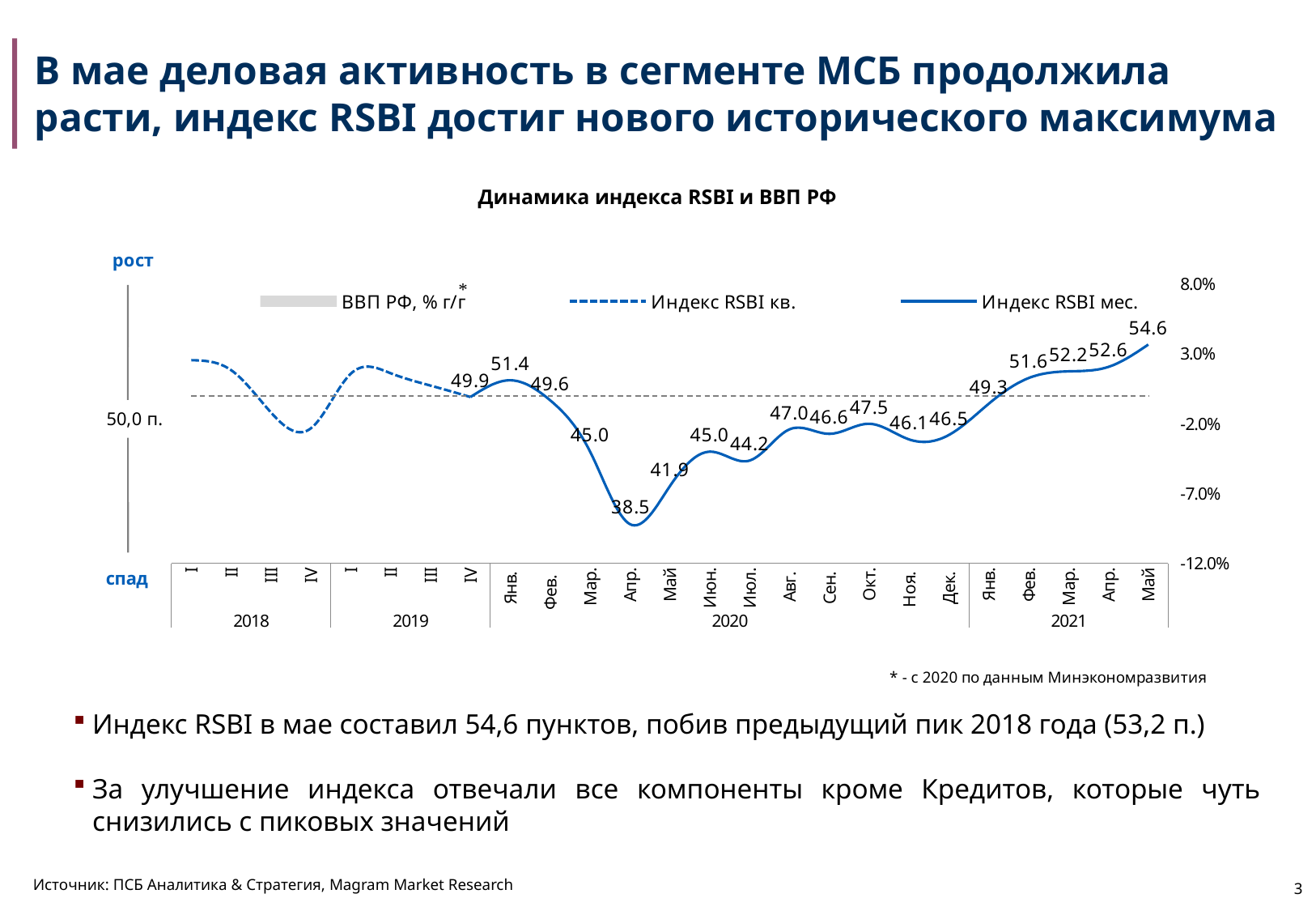
How many series does the chart legend list? 3 What kind of chart is used to show the RSBI index? line chart Is the monthly RSBI index for March 2020 greater or less than 50? less What is the value of the monthly RSBI index (Индекс RSBI мес.) for May 2021? 54.6 Does the monthly RSBI index rise or fall from April 2020 to May 2021? rise In which month does the monthly RSBI index reach its highest labelled value? Май 2021 What is the value of the monthly RSBI index for April 2020? 38.5 What is the value of the monthly RSBI index for October 2020? 47.5 In which month does the monthly RSBI index reach its lowest labelled value? Апр. 2020 Which is larger: the monthly RSBI index in February 2020 or in January 2021? February 2020 (49.6) What is the value of the monthly RSBI index for January 2020? 51.4 What is the difference between the monthly RSBI index in May 2021 and in April 2020? 16.1